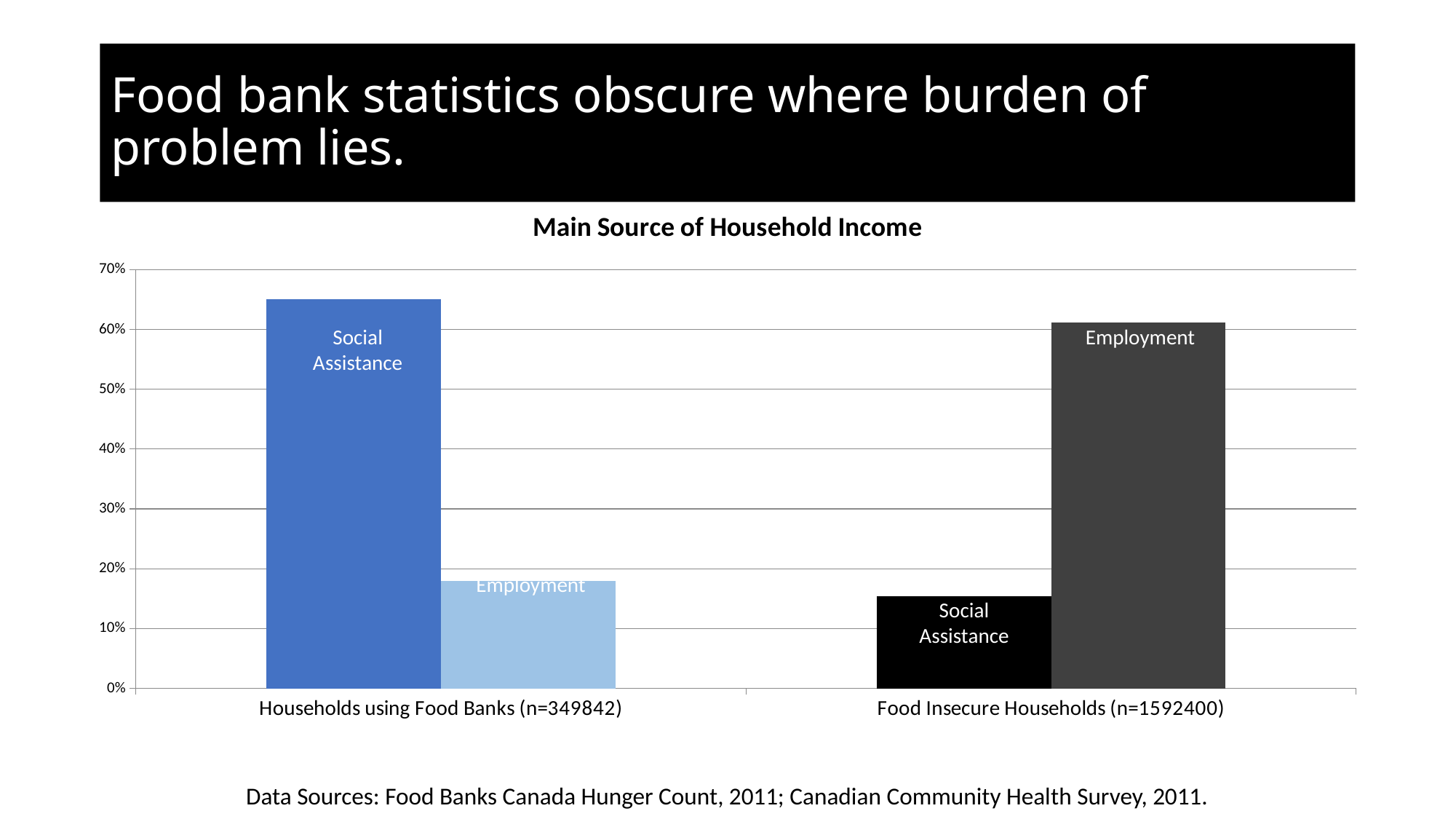
Which income source has the taller bar for Households using Food Banks? Social Assistance What kind of chart is shown on the slide? bar chart Is the Employment value for Households using Food Banks greater or less than 20%? less Which income source has the taller bar for Food Insecure Households? Employment Is the Social Assistance value for Households using Food Banks greater or less than 60%? greater How many household groups (categories) are shown on the x axis? 2 Which bar is the tallest in the chart? Social Assistance for Households using Food Banks Is the Social Assistance value for Food Insecure Households greater or less than 20%? less What is the title of the chart? Main Source of Household Income What is the sample size (n) shown for Food Insecure Households? 1592400 How many income-source series are plotted for each household group? 2